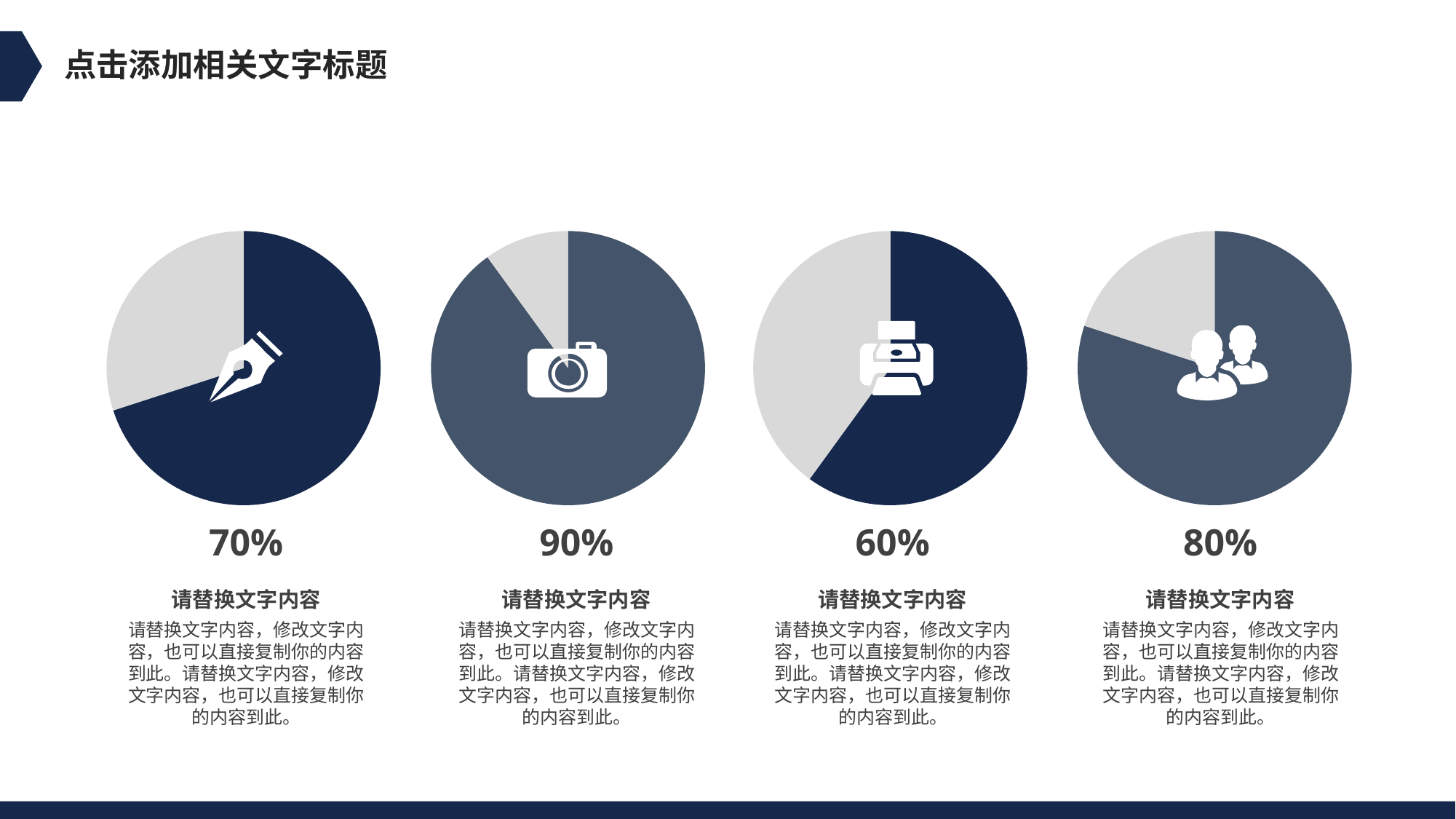
Which pie chart shows the lowest percentage? The third from the left (60%) What kind of chart is used on this slide? Pie chart What percentage is shown below the third pie chart from the left? 60% What percentage is shown below the second pie chart from the left? 90% What percentage is shown below the rightmost pie chart? 80% Which is larger, the percentage of the leftmost pie chart or the rightmost pie chart? The rightmost (80%) In the leftmost pie chart, what share of the pie does the dark slice represent? 70% How many pie charts are on the slide? 4 Which pie chart shows the highest percentage? The second from the left (90%) What is the difference between the percentages of the rightmost and leftmost pie charts? 10% What is the difference between the percentage of the second pie chart and the third pie chart? 30% What percentage is shown below the leftmost pie chart? 70%